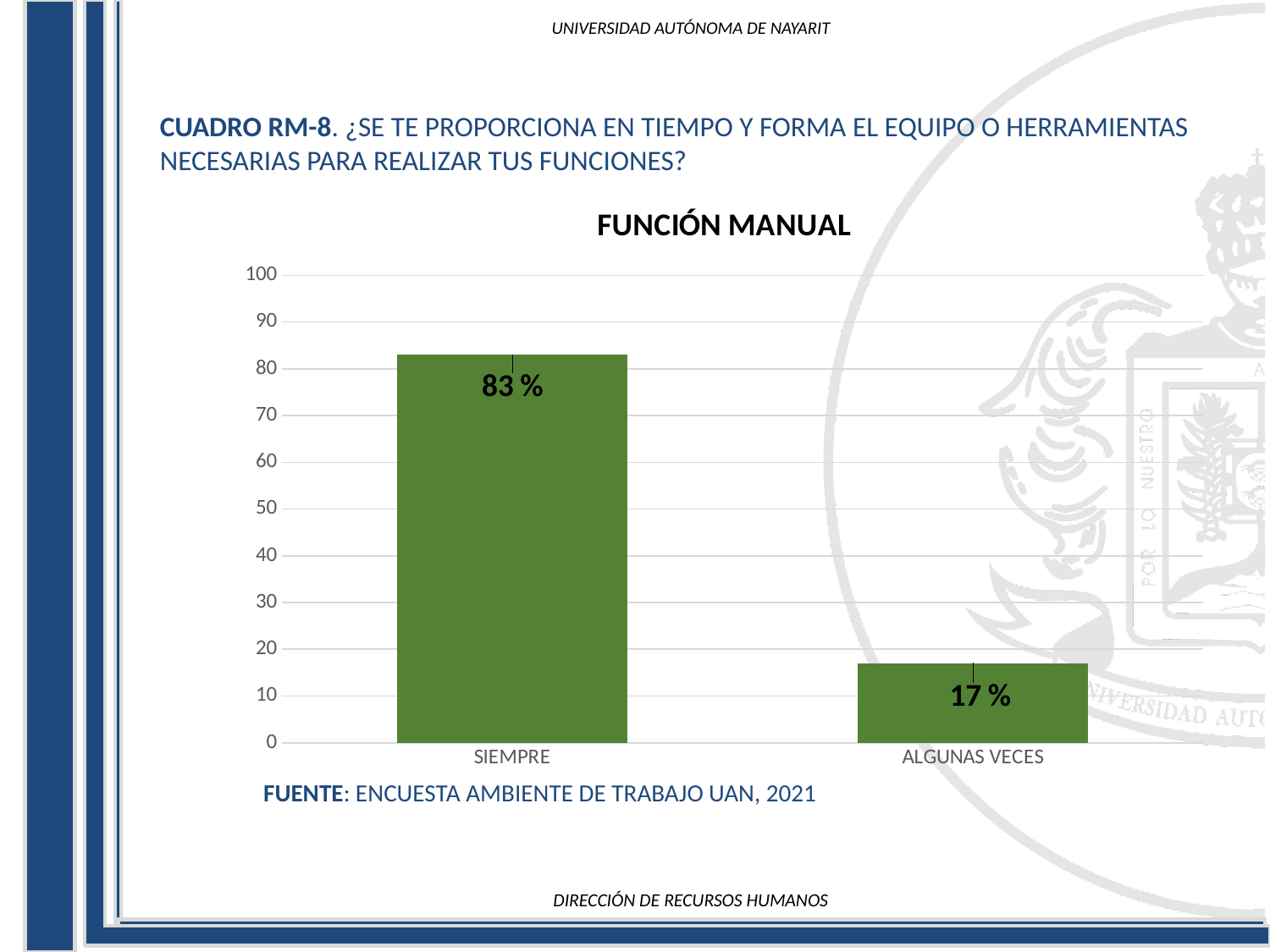
What kind of chart is shown on the slide? bar chart How many categories are shown on the x axis? 2 What is the value for ALGUNAS VECES? 17 % What is the maximum value shown on the y axis? 100 Which category has the lowest value? ALGUNAS VECES What is the value for SIEMPRE? 83 % Which category has the highest value? SIEMPRE What is the difference between the values for SIEMPRE and ALGUNAS VECES? 66 % Which is larger, the value for SIEMPRE or the value for ALGUNAS VECES? SIEMPRE What is the title of the chart? FUNCIÓN MANUAL Is the value for ALGUNAS VECES greater or less than 20? less Is the value for SIEMPRE greater or less than 80? greater